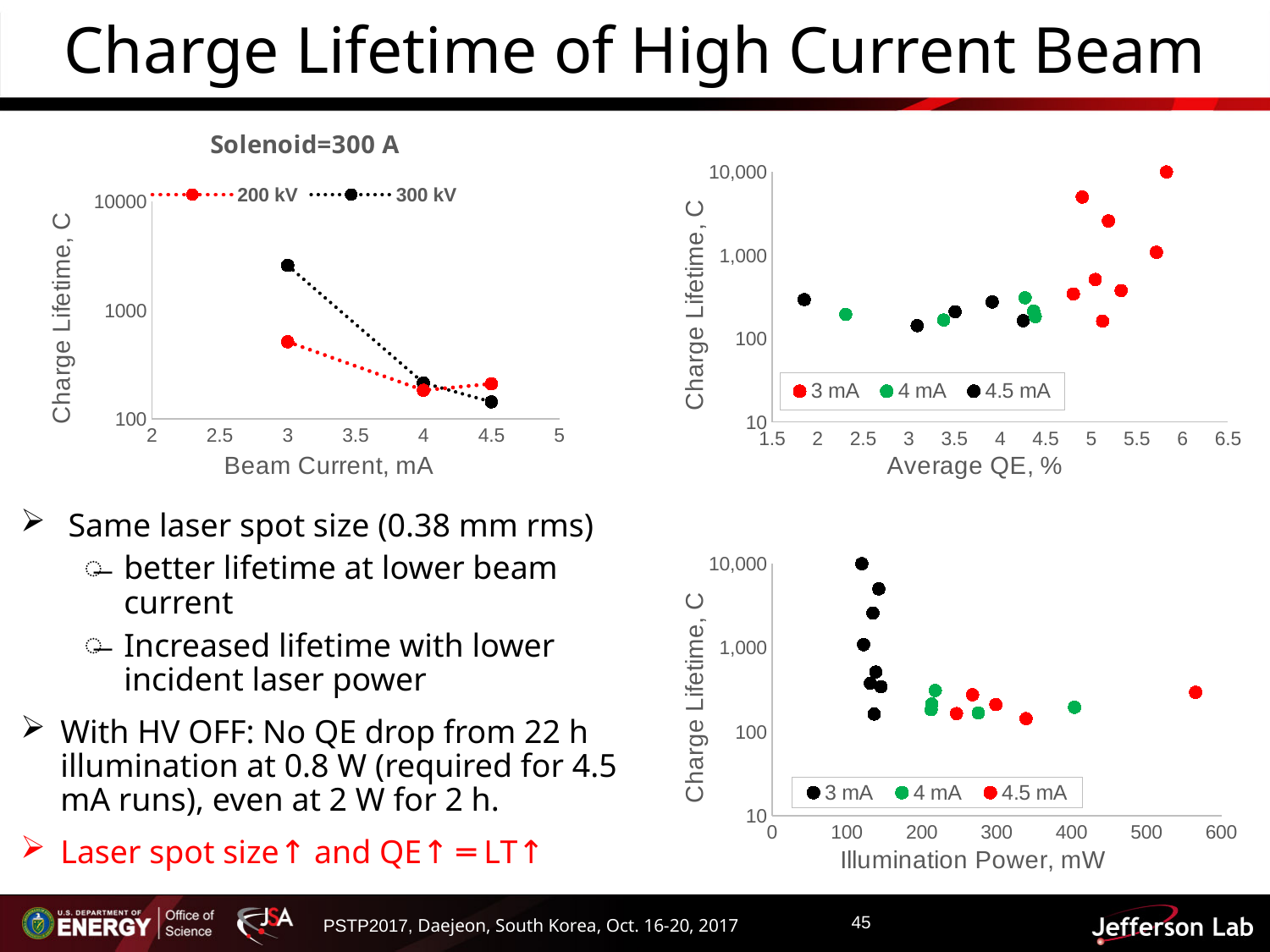
How many series does the legend of the top-left chart (Solenoid=300 A) list? 2 What is the title of the top-left chart? Solenoid=300 A In the top-left chart (Solenoid=300 A), at 3 mA beam current, which series has the higher charge lifetime, 200 kV or 300 kV? 300 kV In the bottom-right chart (Charge Lifetime vs Illumination Power), does charge lifetime generally rise or fall as illumination power increases? fall In the top-right chart (Charge Lifetime vs Average QE), does charge lifetime generally rise or fall as average QE increases? rise In the top-left chart (Solenoid=300 A), does charge lifetime rise or fall as beam current increases? fall In the top-left chart (Solenoid=300 A), is the 200 kV charge lifetime at 3 mA greater or less than 1000 C? less What kind of chart is the top-left chart (Solenoid=300 A)? scatter chart with dotted lines In the top-left chart (Solenoid=300 A), is the 300 kV charge lifetime at 3 mA greater or less than 1000 C? greater What is the x-axis label of the bottom-right chart? Illumination Power, mW In the top-left chart (Solenoid=300 A), how many data points does the 200 kV series have? 3 How many series does the legend of the top-right chart (Charge Lifetime vs Average QE) list? 3